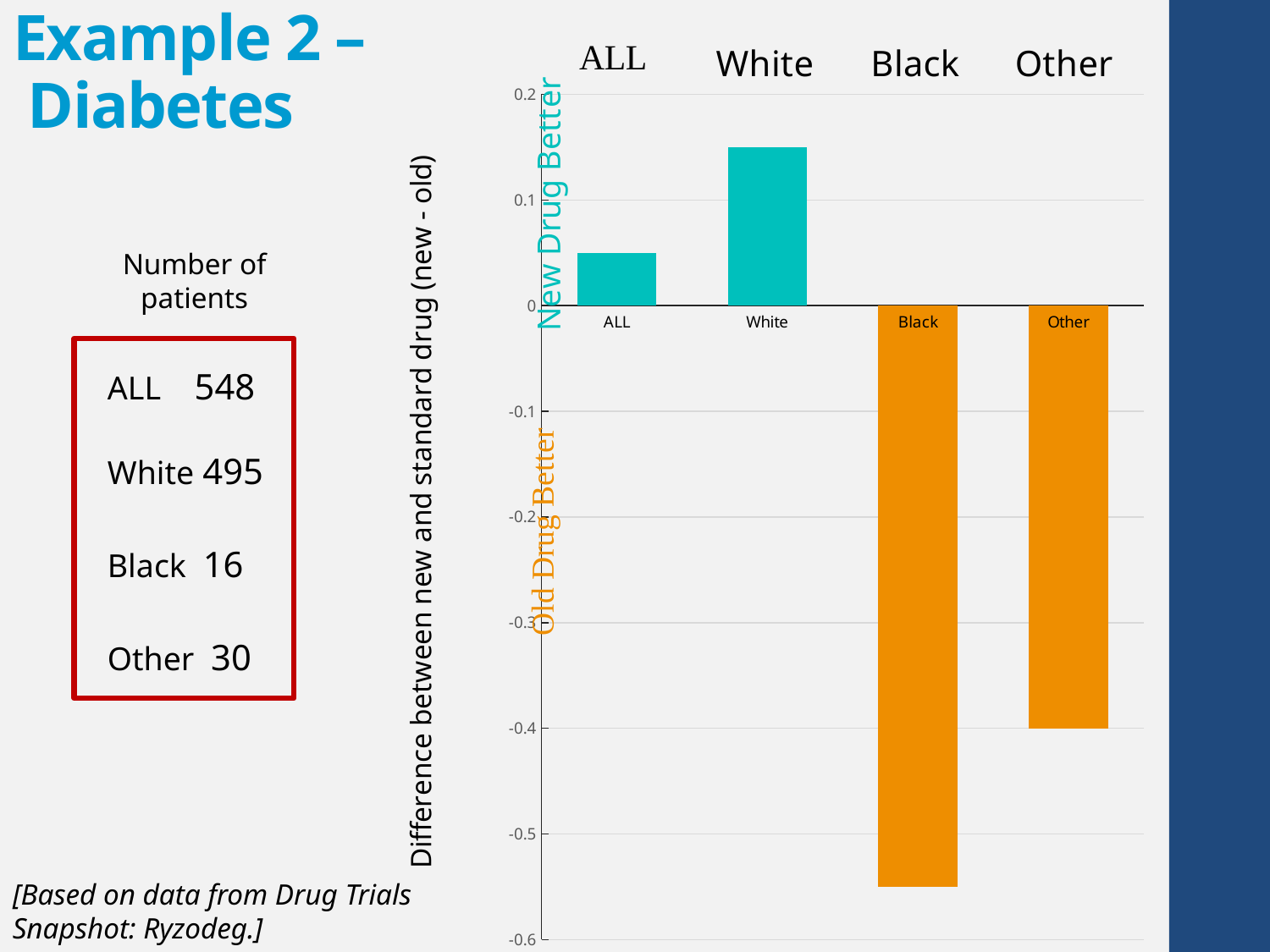
Which has the larger value, Black or Other? Other What is the value for Other in the chart? -0.4 How many categories are plotted in the chart? 4 Is the value for ALL greater or less than 0.1? less Which category has the highest value in the chart? White Which has the larger value, ALL or White? White Which category has the lowest value in the chart? Black Is the value for Black greater or less than -0.5? less What is the title of the vertical axis of the chart? Difference between new and standard drug (new - old) Is the value for White greater or less than 0.1? greater What kind of chart is shown on the slide? bar chart How many bars in the chart have a positive value? 2